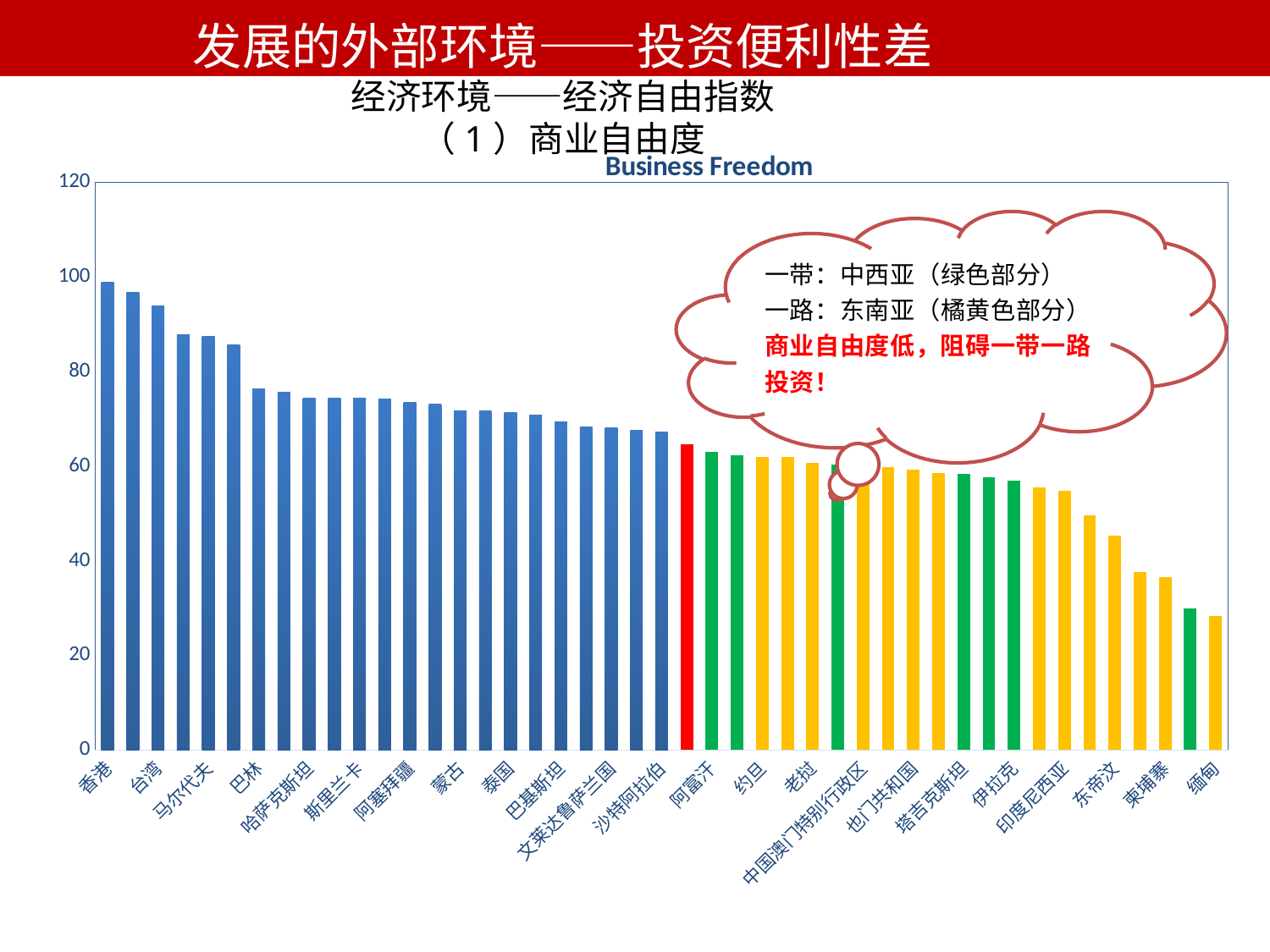
Is the value for 香港 greater or less than 80? greater Which has the larger value, 香港 or 缅甸? 香港 What kind of chart is shown on the slide? bar chart Is the value for 巴林 greater or less than 80? less Is the value for 缅甸 greater or less than 40? less Do the values rise or fall from left to right along the x axis? fall Which category has the lowest value in the Business Freedom chart? 缅甸 Which category has the highest value in the Business Freedom chart? 香港 Which has the larger value, 马尔代夫 or 柬埔寨? 马尔代夫 What is the title of the chart? Business Freedom